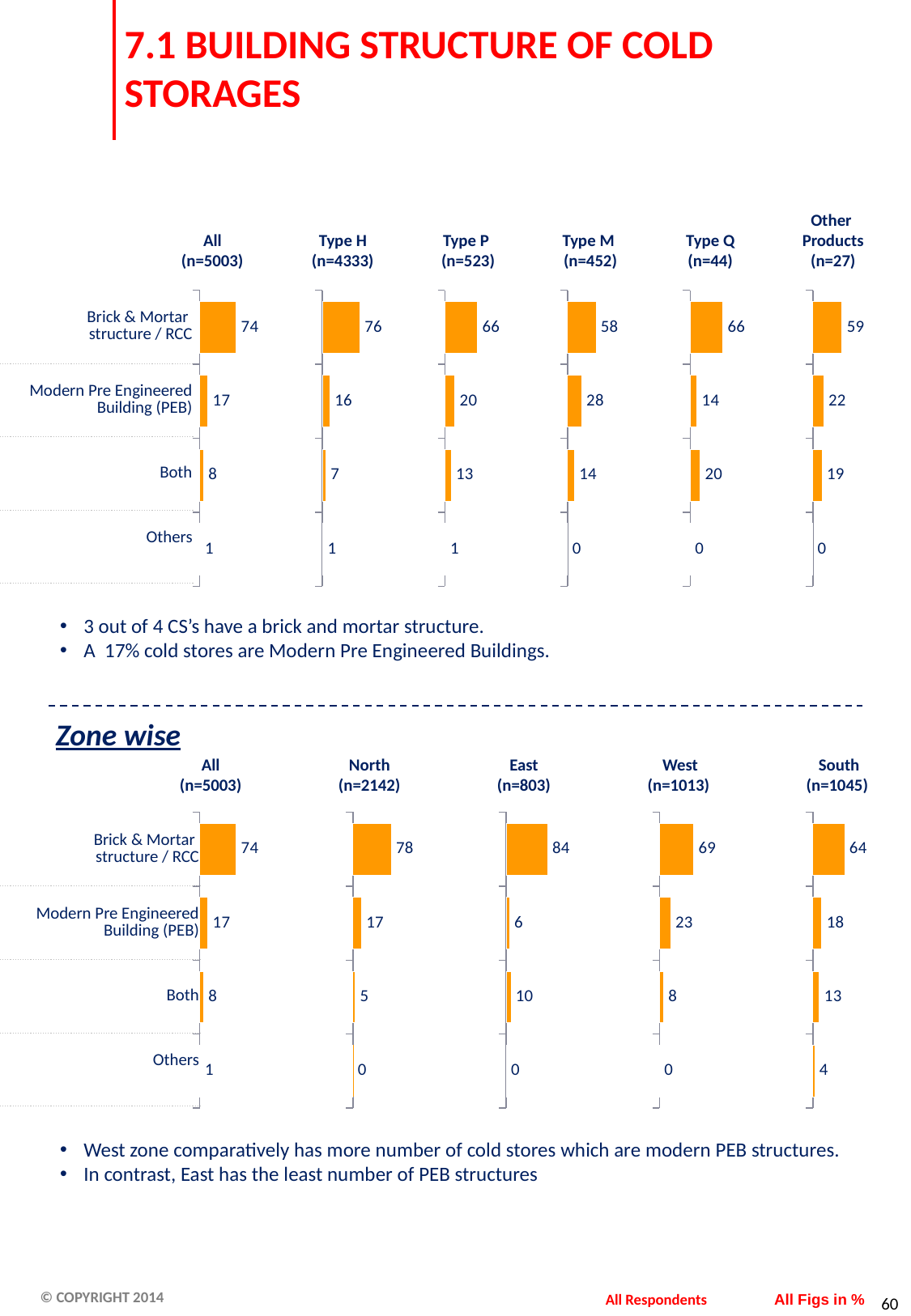
In the top panel, which category has the lowest value in the Type P (n=523) chart? Others In the Zone wise panel, what is the value for Modern Pre Engineered Building (PEB) in the West (n=1013) chart? 23 In the top panel, which category has the highest value in the Other Products (n=27) chart? Brick & Mortar structure / RCC In the top panel, what is the difference between the Brick & Mortar structure / RCC values in the Type H chart and the Type M chart? 18 What type of chart is used in the Zone wise panel? Bar chart In the top panel, what is the value for Both in the Type Q (n=44) chart? 20 In the Zone wise panel, what is the value for Brick & Mortar structure / RCC in the East (n=803) chart? 84 How many categories are shown in each chart of the Zone wise panel? 4 In the top panel, what is the value for Modern Pre Engineered Building (PEB) in the Type M (n=452) chart? 28 In the top panel, what is the value for Brick & Mortar structure / RCC in the Type H (n=4333) chart? 76 In the Zone wise panel, what is the value for Others in the South (n=1045) chart? 4 In the Zone wise panel, which is larger: the Both value in the South chart or the Both value in the North chart? South